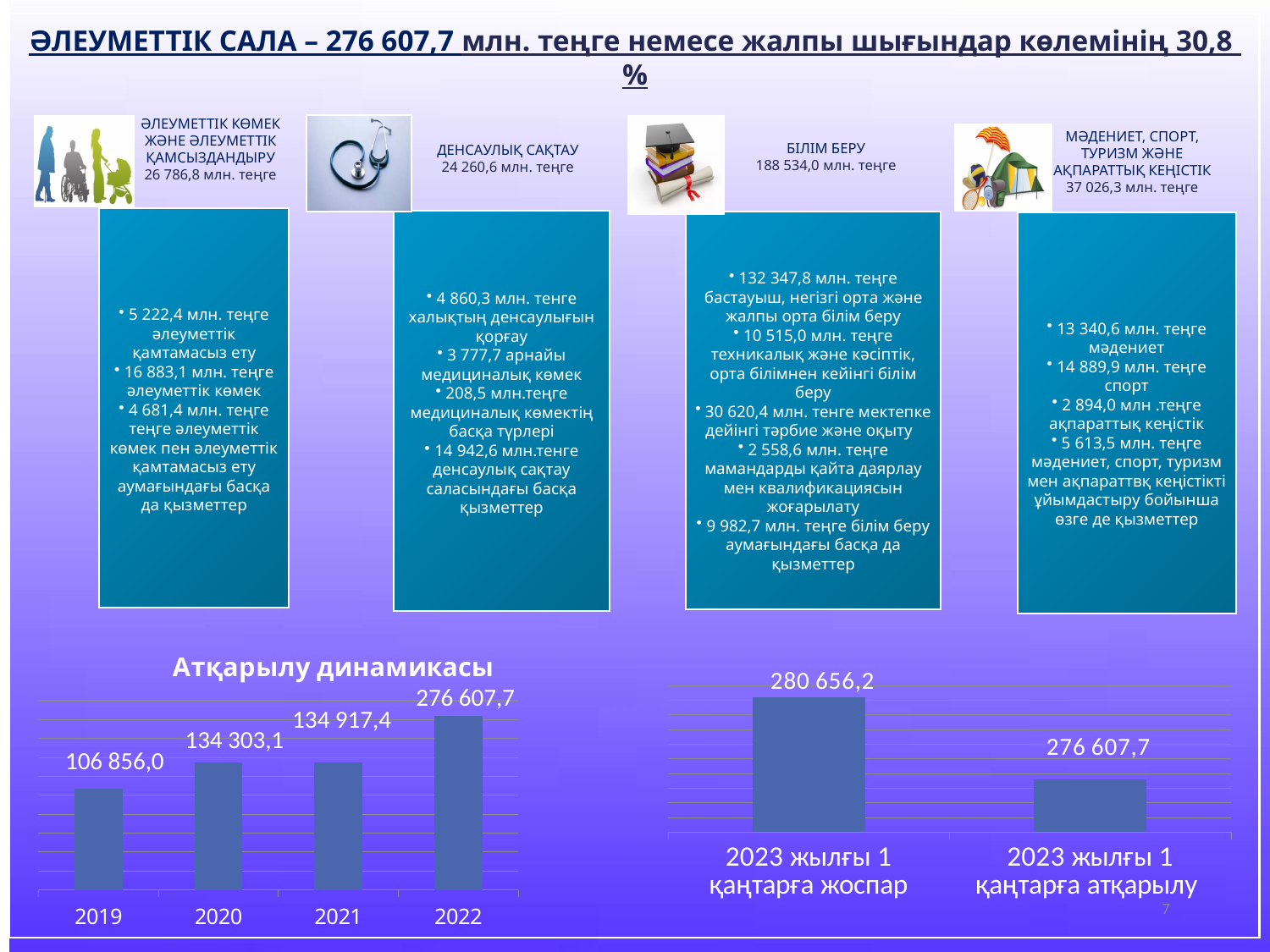
In the chart titled "Атқарылу динамикасы", what is the value for 2019? 106 856,0 In the bottom-right chart, what is the difference between "2023 жылғы 1 қаңтарға жоспар" and "2023 жылғы 1 қаңтарға атқарылу"? 4 048,5 In the chart titled "Атқарылу динамикасы", how many years are shown on the x axis? 4 In the chart titled "Атқарылу динамикасы", which year has the lowest value? 2019 In the chart titled "Атқарылу динамикасы", do the values rise or fall from 2019 to 2022? rise In the chart titled "Атқарылу динамикасы", what is the value for 2022? 276 607,7 In the chart titled "Атқарылу динамикасы", what is the value for 2020? 134 303,1 In the bottom-right chart, what is the value for "2023 жылғы 1 қаңтарға жоспар"? 280 656,2 In the bottom-right chart, which is larger: "2023 жылғы 1 қаңтарға жоспар" or "2023 жылғы 1 қаңтарға атқарылу"? 2023 жылғы 1 қаңтарға жоспар What kind of chart is the chart titled "Атқарылу динамикасы"? bar chart In the chart titled "Атқарылу динамикасы", which year has the highest value? 2022 In the chart titled "Атқарылу динамикасы", what is the difference between the values for 2022 and 2019? 169 751,7